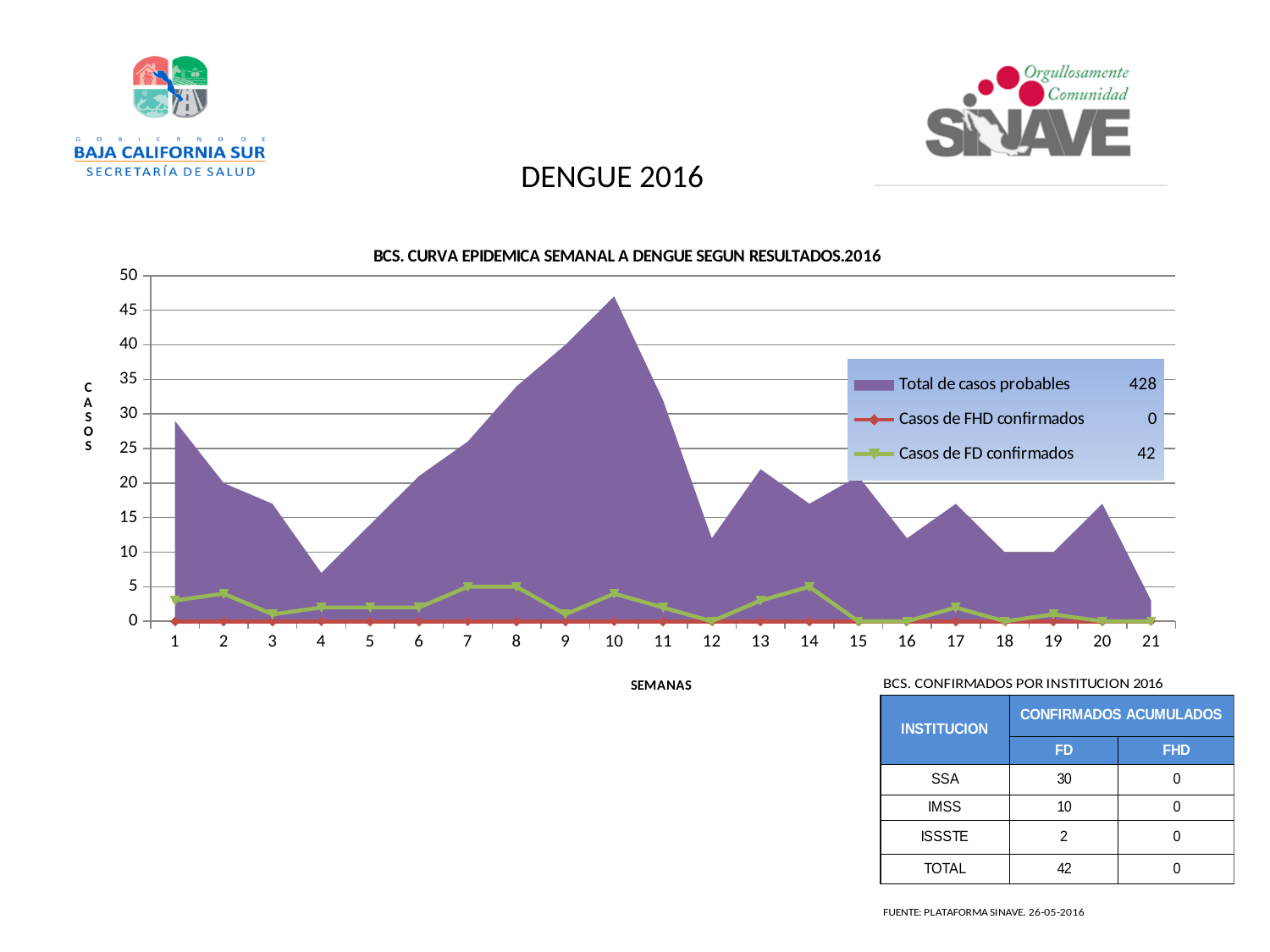
Does 'Total de casos probables' rise or fall from week 4 to week 10? rise Which week has the larger value of 'Total de casos probables', week 13 or week 14? week 13 Is the value of 'Total de casos probables' in week 1 greater or less than 25? greater What total is shown in the legend for 'Casos de FHD confirmados'? 0 What is the title of the chart? BCS. CURVA EPIDEMICA SEMANAL A DENGUE SEGUN RESULTADOS.2016 How many series does the chart legend list? 3 Is the value of 'Total de casos probables' in week 4 greater or less than 10? less In which week does 'Total de casos probables' reach its highest value? 10 How many weeks (semanas) are shown on the x axis of the chart? 21 What total is shown in the legend for 'Casos de FD confirmados'? 42 Is the value of 'Total de casos probables' in week 10 greater or less than 40? greater What total is shown in the legend for 'Total de casos probables'? 428